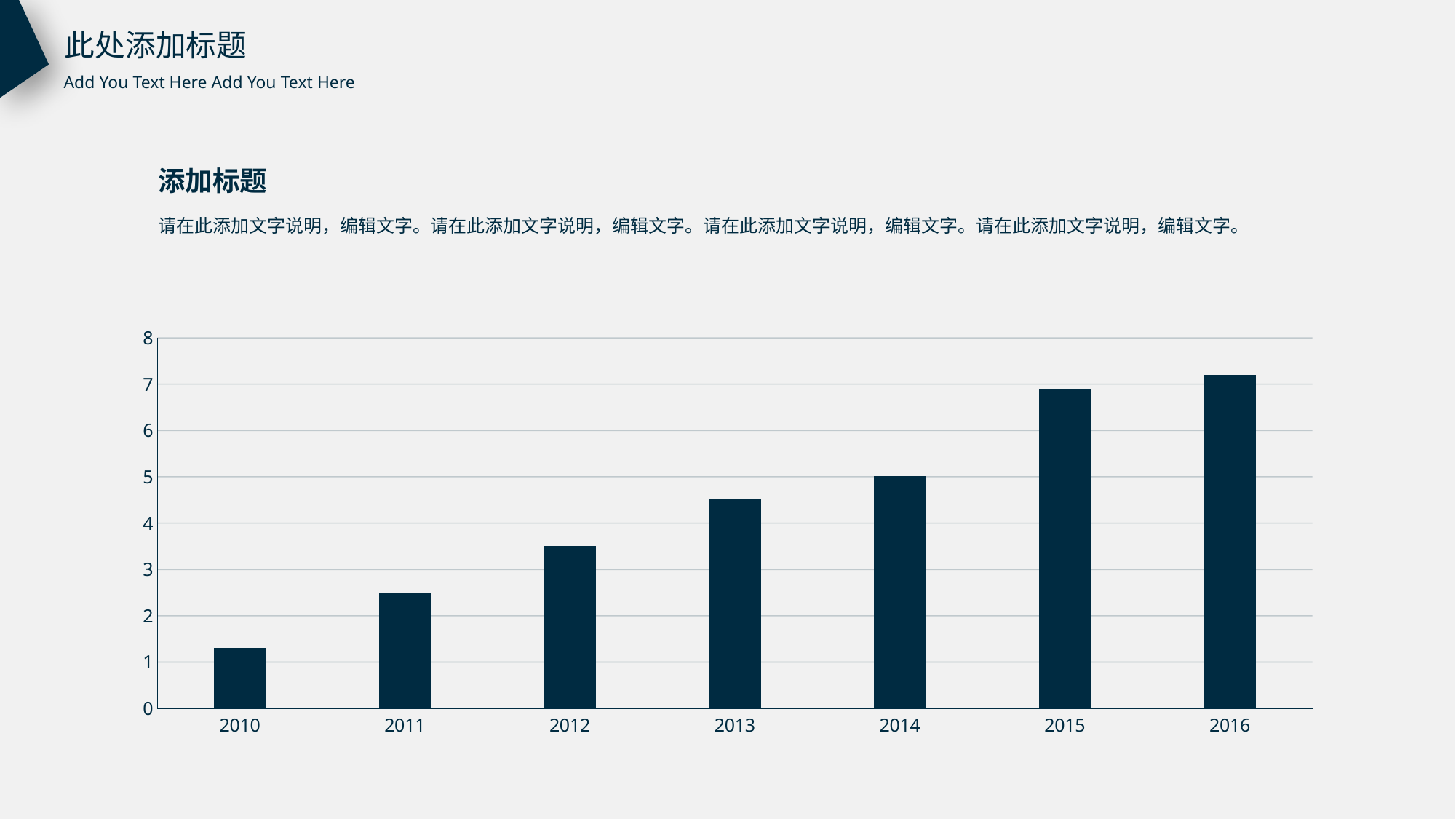
Is the value for 2016 greater or less than 7? greater Is the value for 2013 greater or less than 5? less Which is larger, the value for 2011 or the value for 2013? 2013 Is the value for 2010 greater or less than 2? less Which year has the lowest bar in the chart? 2010 How many years are shown on the x axis of the chart? 7 What is the highest value shown on the y axis of the chart? 8 Do the bar values rise or fall from 2010 to 2016? rise Which year has the highest bar in the chart? 2016 What kind of chart is shown on the slide? bar chart